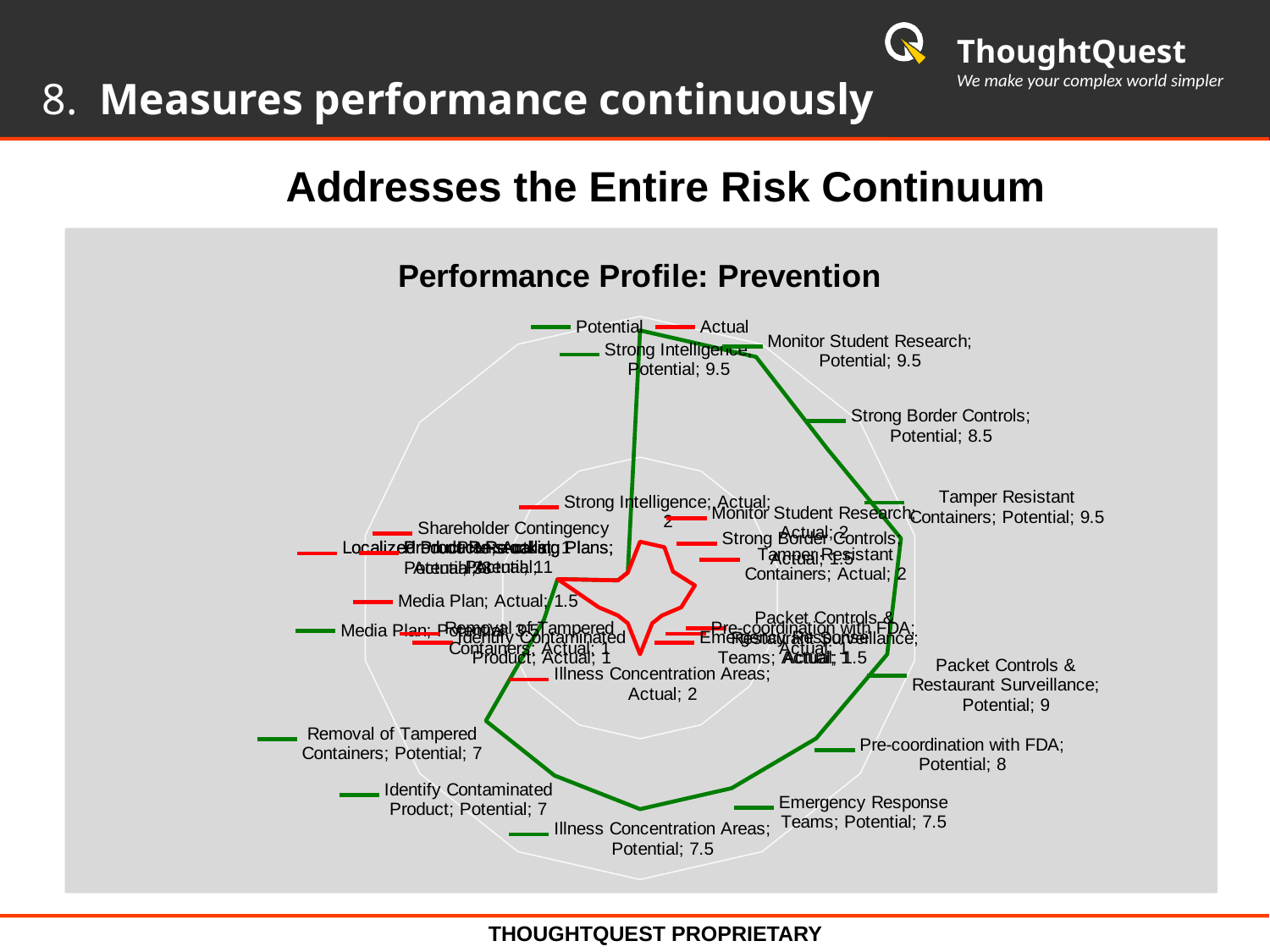
What is the title of the chart? Performance Profile: Prevention What kind of chart is shown on the slide? Radar chart Which series is drawn in red? Actual What is the Actual value for Identify Contaminated Product? 1 How many series does the chart legend list? 2 What is the Actual value for Strong Intelligence? 2 Which is larger, the Potential value for Pre-coordination with FDA or the Potential value for Emergency Response Teams? Pre-coordination with FDA What is the Potential value for Tamper Resistant Containers? 9.5 What is the difference between the Potential and Actual values for Strong Intelligence? 7.5 What is the Potential value for Strong Border Controls? 8.5 What is the Potential value for Packet Controls & Restaurant Surveillance? 9 What is the Potential value for Removal of Tampered Containers? 7